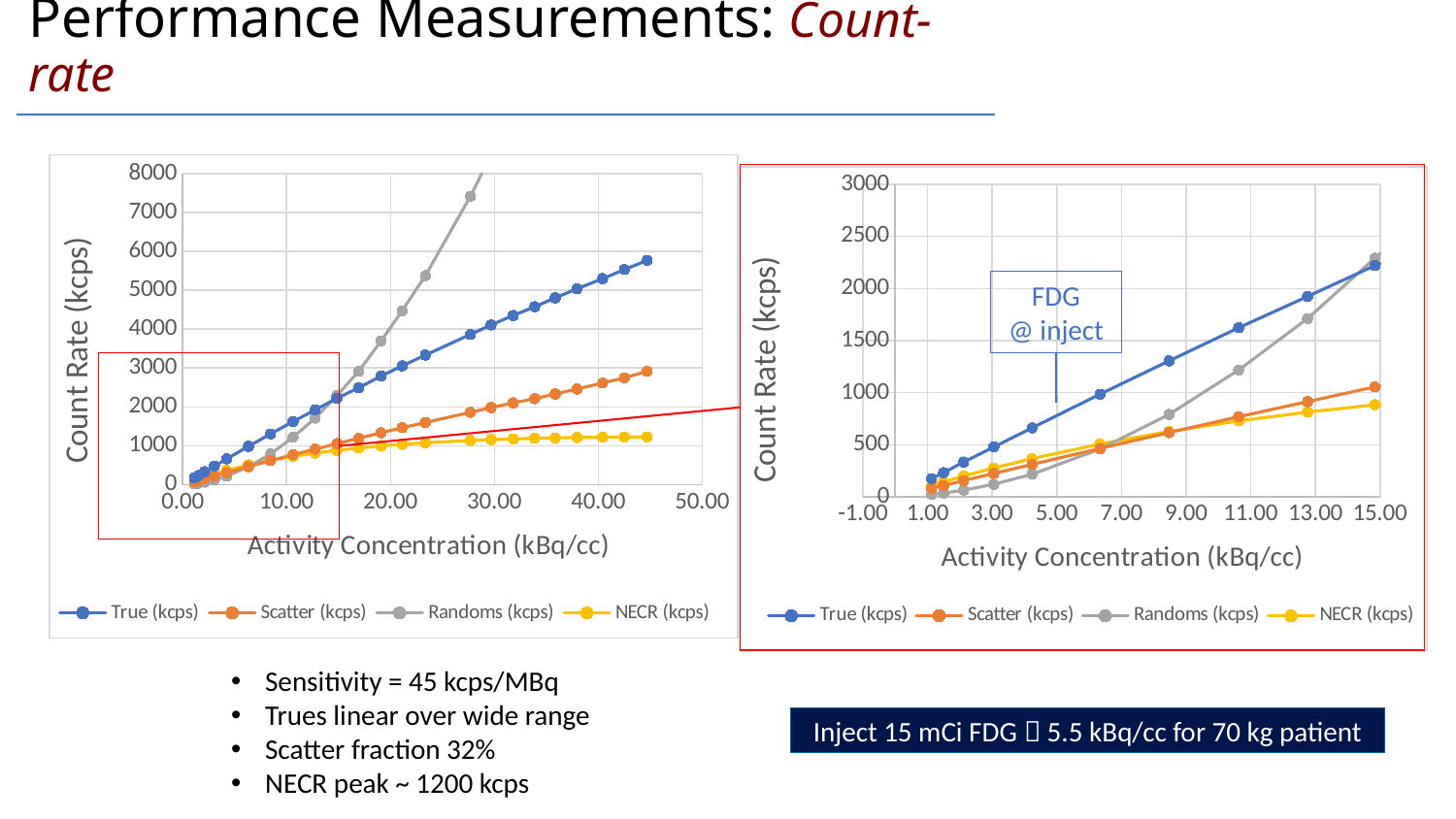
On the right chart, at an activity concentration of 9.00, which is larger: Randoms (kcps) or Scatter (kcps)? Randoms (kcps) How many series does the legend of the right chart list? 4 What is the x-axis title of the right chart? Activity Concentration (kBq/cc) What annotation label is shown inside the right chart? FDG @ inject On the right chart, does the True (kcps) series rise or fall as activity concentration increases? rise On the left chart, is the value of NECR (kcps) at an activity concentration of 45.00 greater or less than 2000? less On the left chart, is the value of True (kcps) at an activity concentration of 40.00 greater or less than 4000? greater On the left chart, which series is highest at an activity concentration of about 25.00? Randoms (kcps) On the right chart, is the value of NECR (kcps) at an activity concentration of 15.00 greater or less than 1000? less What type of chart is the left chart? line chart On the left chart, which series is lowest at an activity concentration of about 45.00? NECR (kcps)